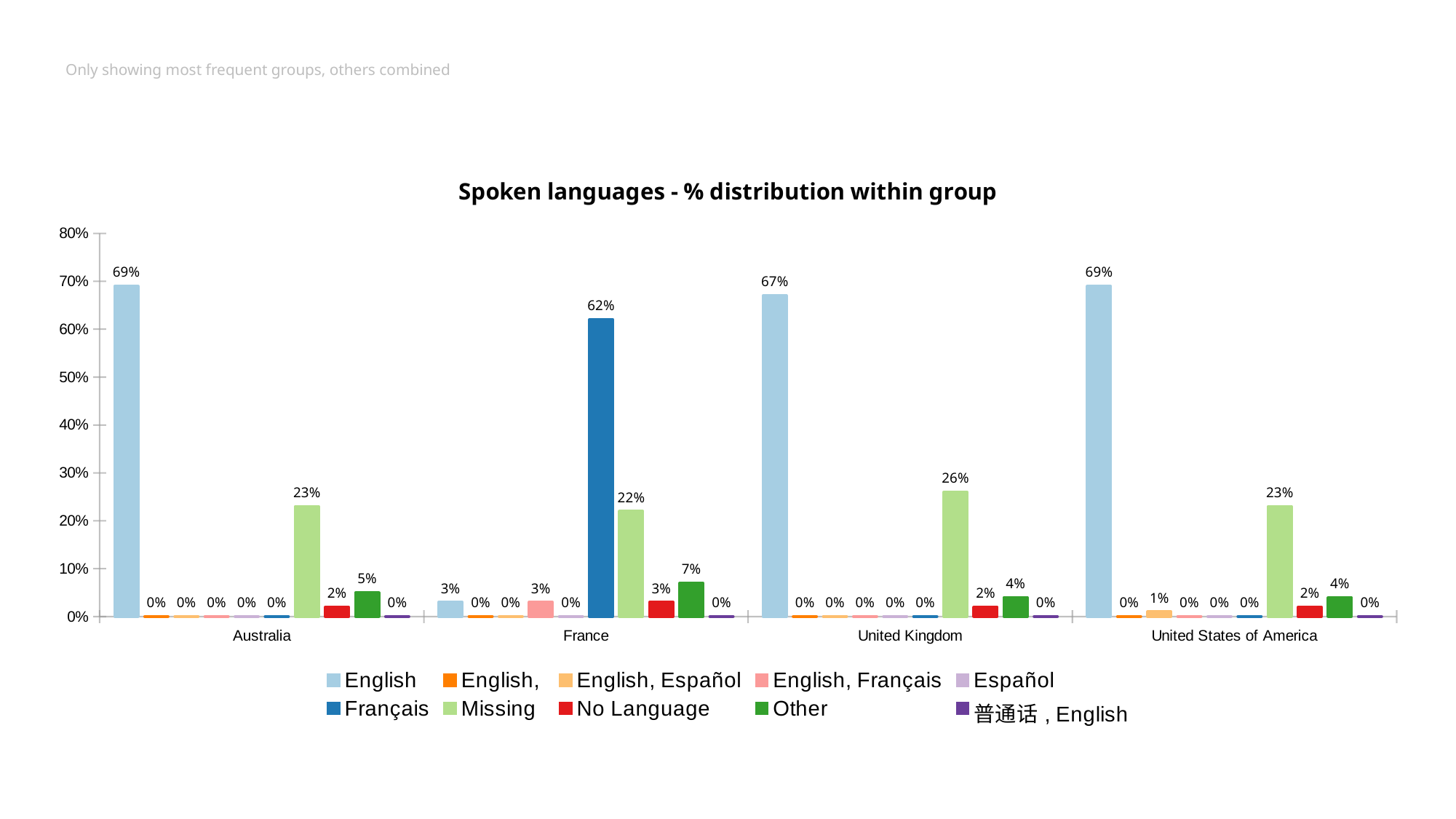
What type of chart is shown on the slide? Bar chart How many series does the legend list? 10 What is the value for English, Español in the United States of America group? 1% What is the value for English in the United Kingdom group? 67% What is the value for Other in the France group? 7% What is the difference between the English value for Australia and the English value for the United Kingdom? 2% Which country group has the highest value for Missing? United Kingdom How many country groups are shown on the x axis? 4 What is the value for Français in the France group? 62% Which country group has the lowest value for English? France What is the value for Missing in the United Kingdom group? 26% Which is larger: the Other value for Australia or the Other value for the United Kingdom? Australia